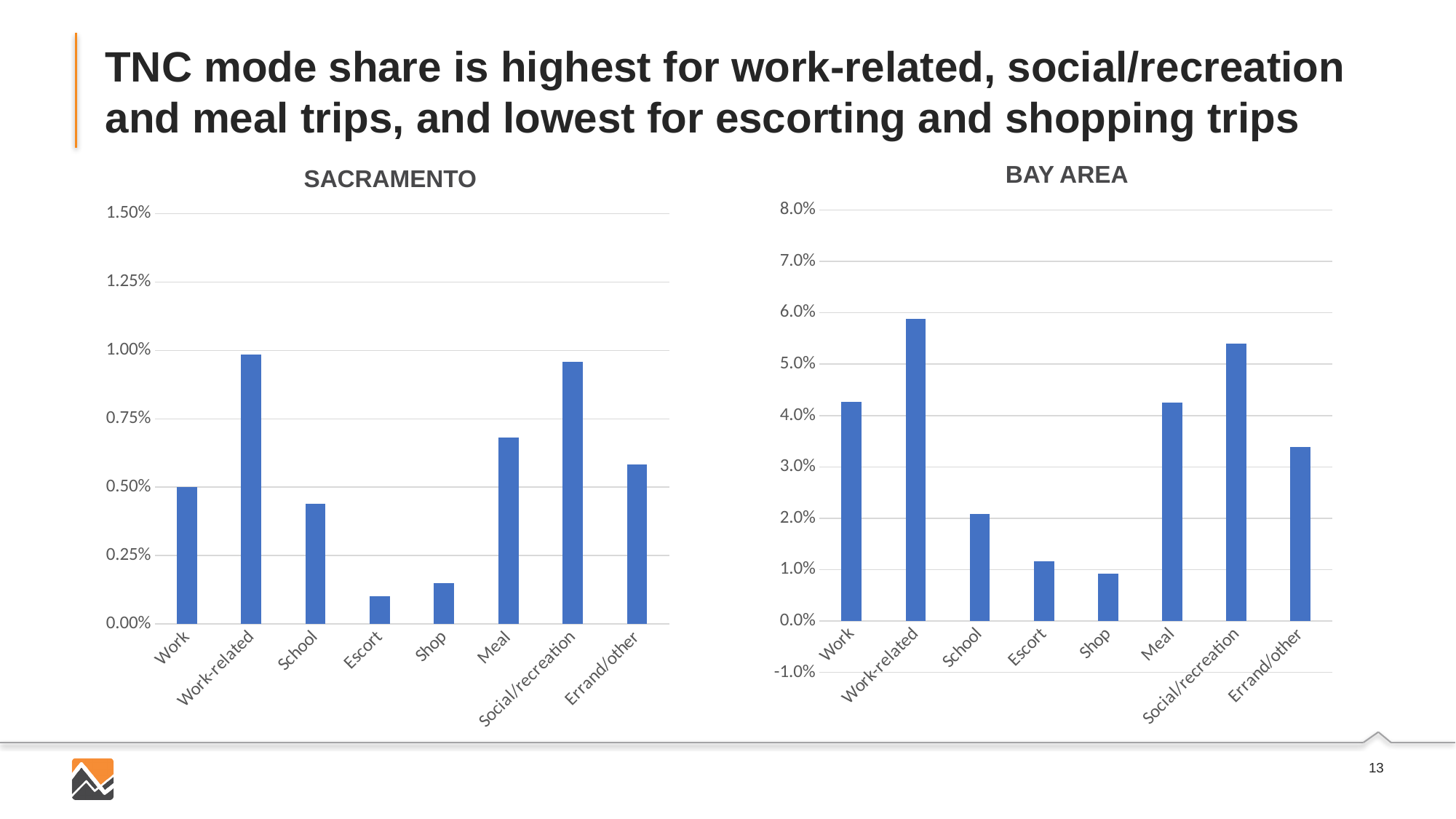
How many trip-purpose categories are shown on the BAY AREA chart? 8 On the BAY AREA chart, is the value for Social/recreation greater or less than 5.0%? greater What kind of chart is the SACRAMENTO chart? bar chart On the BAY AREA chart, which is larger, the value for Work-related or the value for Social/recreation? Work-related On the SACRAMENTO chart, which category has the lowest TNC mode share? Escort On the BAY AREA chart, is the value for Errand/other greater or less than 3.0%? greater On the BAY AREA chart, which category has the highest TNC mode share? Work-related On the SACRAMENTO chart, is the value for Escort greater or less than 0.25%? less What is the title of the chart on the left side of the slide? SACRAMENTO On the BAY AREA chart, which category has the lowest TNC mode share? Shop On the SACRAMENTO chart, which is larger, the value for Meal or the value for Errand/other? Meal